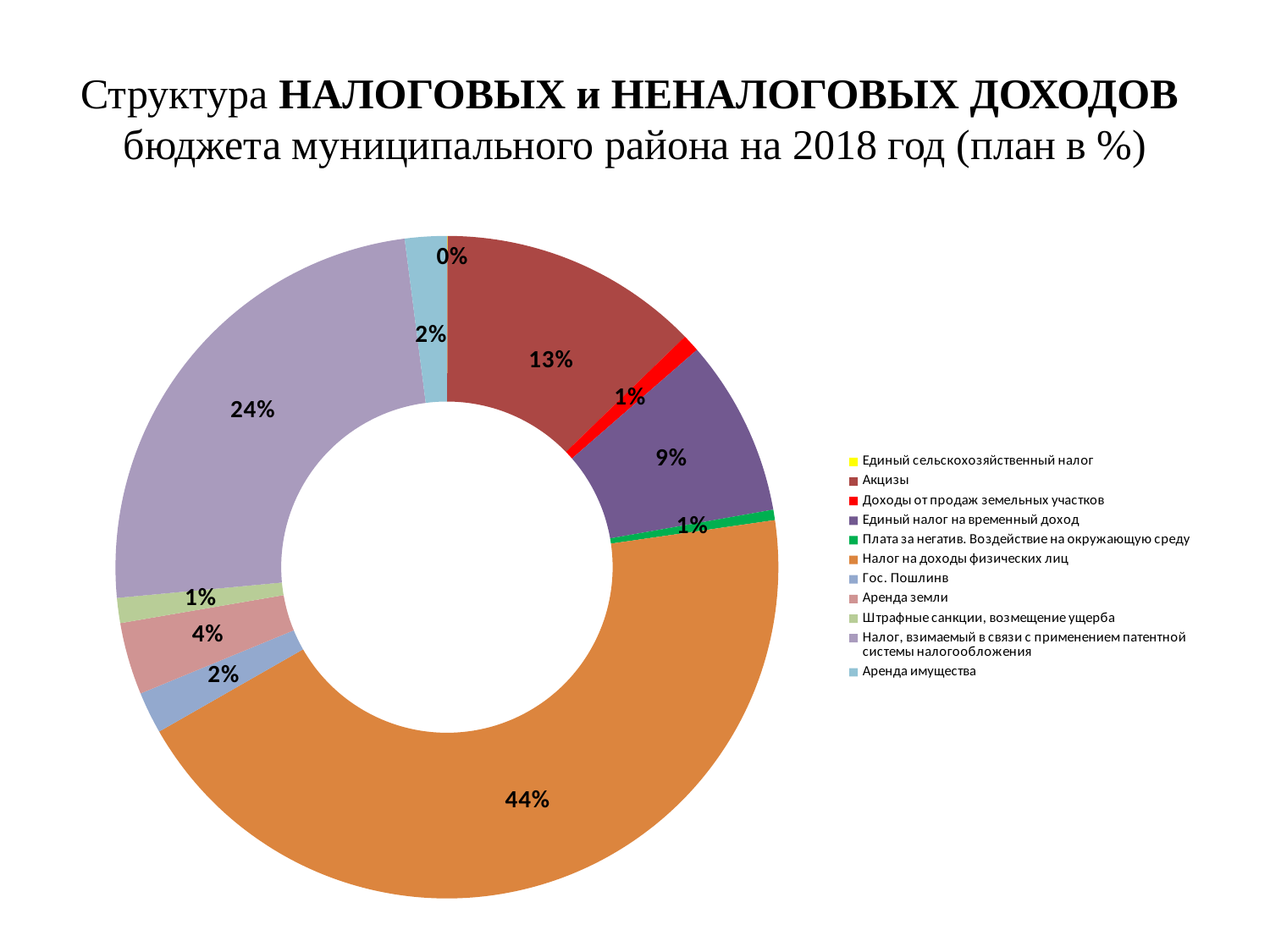
What is the difference in percentage points between Налог на доходы физических лиц and Налог, взимаемый в связи с применением патентной системы налогообложения? 20 What value is labelled for Единый сельскохозяйственный налог? 0% What percentage is shown for Аренда земли? 4% What is the value shown for Единый налог на временный доход? 9% How many categories does the legend list? 11 What share of the chart does Налог на доходы физических лиц account for? 44% What kind of chart is shown on the slide? doughnut chart Which category has the largest share of the chart? Налог на доходы физических лиц What share is shown for Налог, взимаемый в связи с применением патентной системы налогообложения? 24% Which category has the smallest share of the chart? Единый сельскохозяйственный налог What percentage is labelled for Акцизы? 13% Which is larger, the share for Акцизы or the share for Единый налог на временный доход? Акцизы